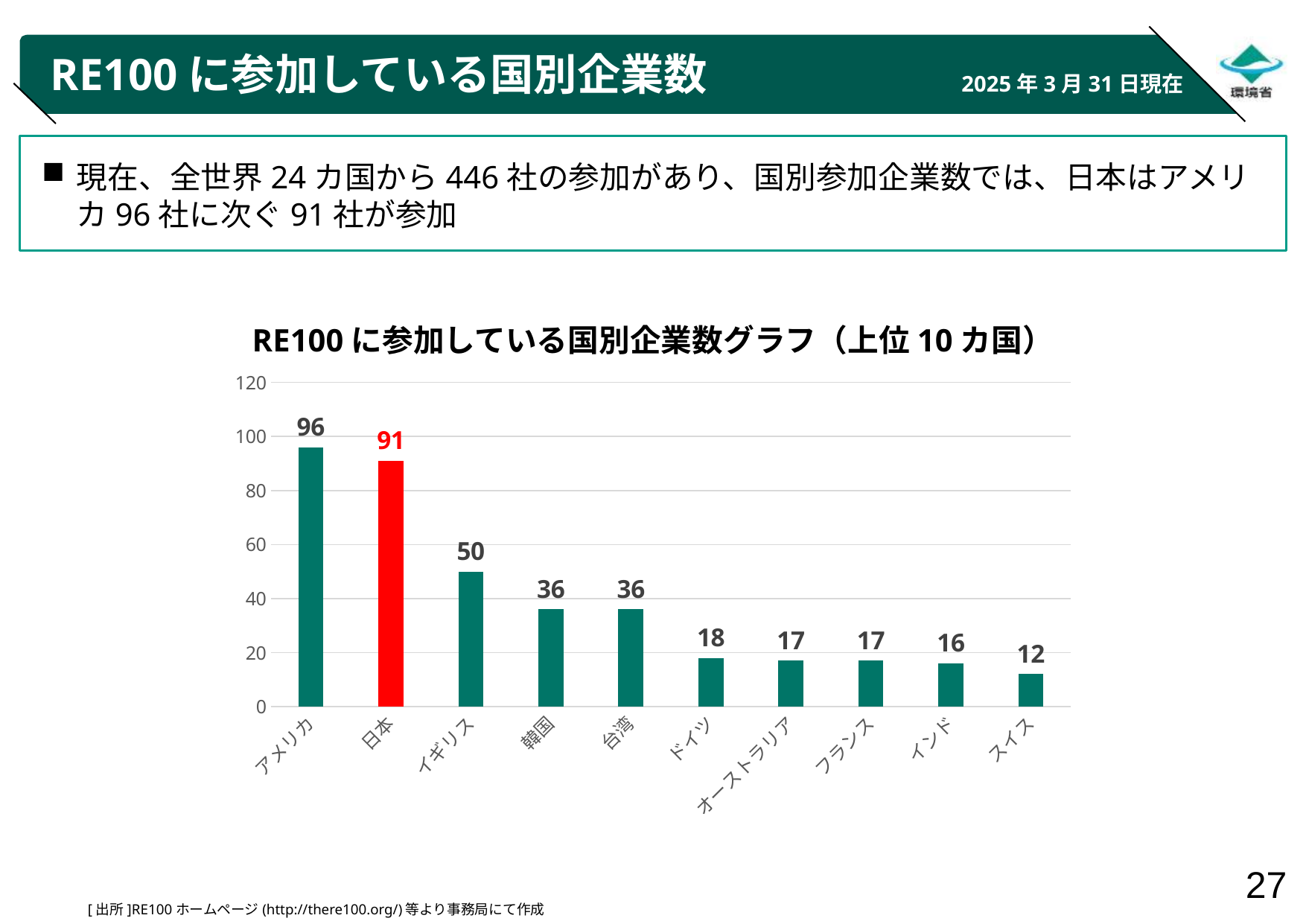
What kind of chart is shown on the slide? bar chart Is the value for 台湾 greater or less than 40? less Which bar in the chart is coloured red? 日本 What is the value for 日本 (Japan) in the chart? 91 Which is larger, the value for ドイツ or the value for インド? ドイツ What is the difference between the values for イギリス and 韓国? 14 Which country has the lowest number of participating companies? スイス What is the difference between the values for アメリカ and 日本? 5 What is the value for スイス (Switzerland) in the chart? 12 What is the value for イギリス (UK) in the chart? 50 Which country has the highest number of participating companies? アメリカ How many countries are shown in the chart? 10